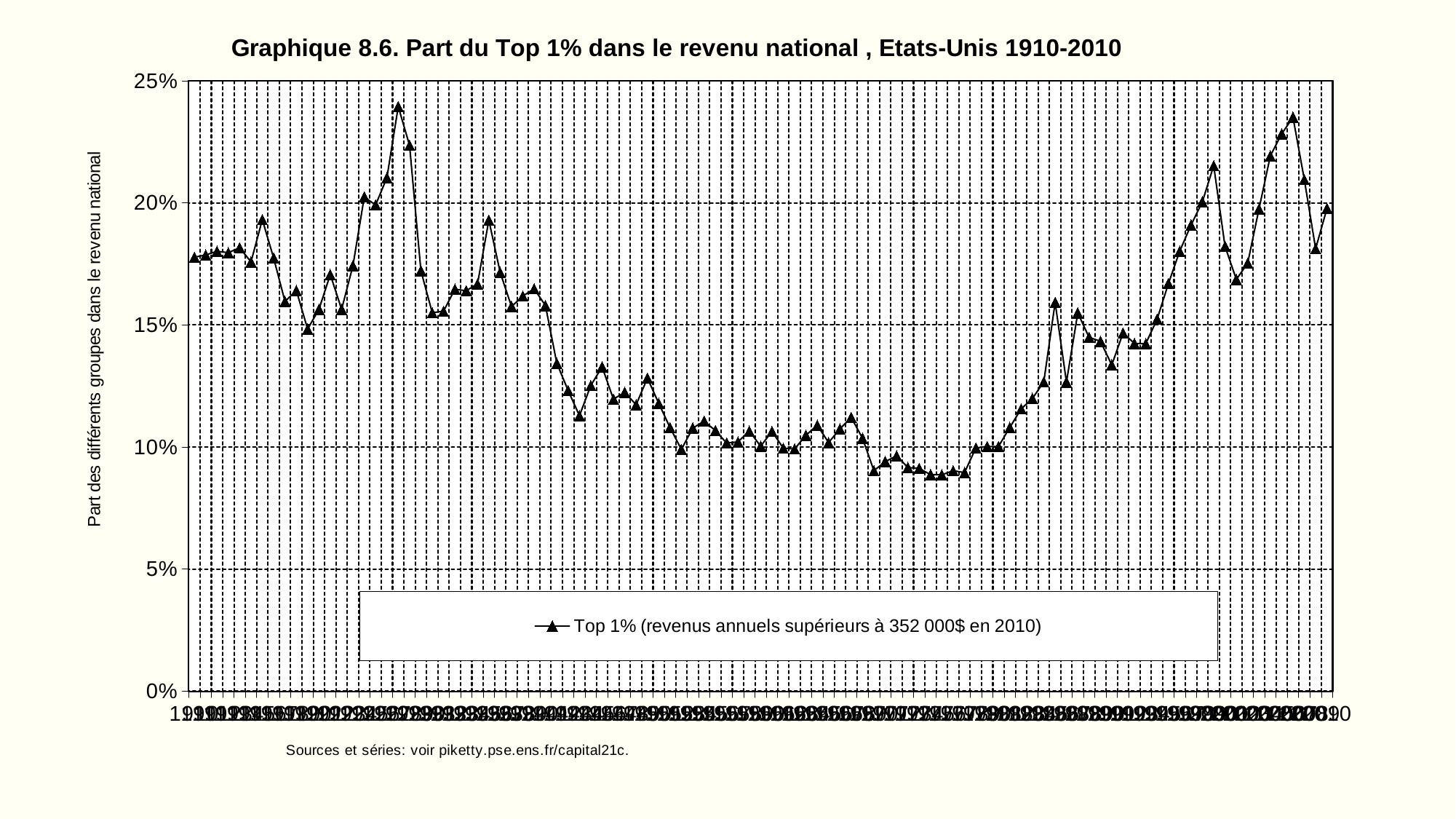
Is the highest point of the series greater or less than 20%? greater Is the lowest point of the series greater or less than 5%? greater What kind of chart is shown on the slide? line chart Is the last (rightmost) point of the series greater or less than 15%? greater What is the title of the chart? Graphique 8.6. Part du Top 1% dans le revenu national , Etats-Unis 1910-2010 What is the legend entry for the plotted series? Top 1% (revenus annuels supérieurs à 352 000$ en 2010) How many series does the legend list? 1